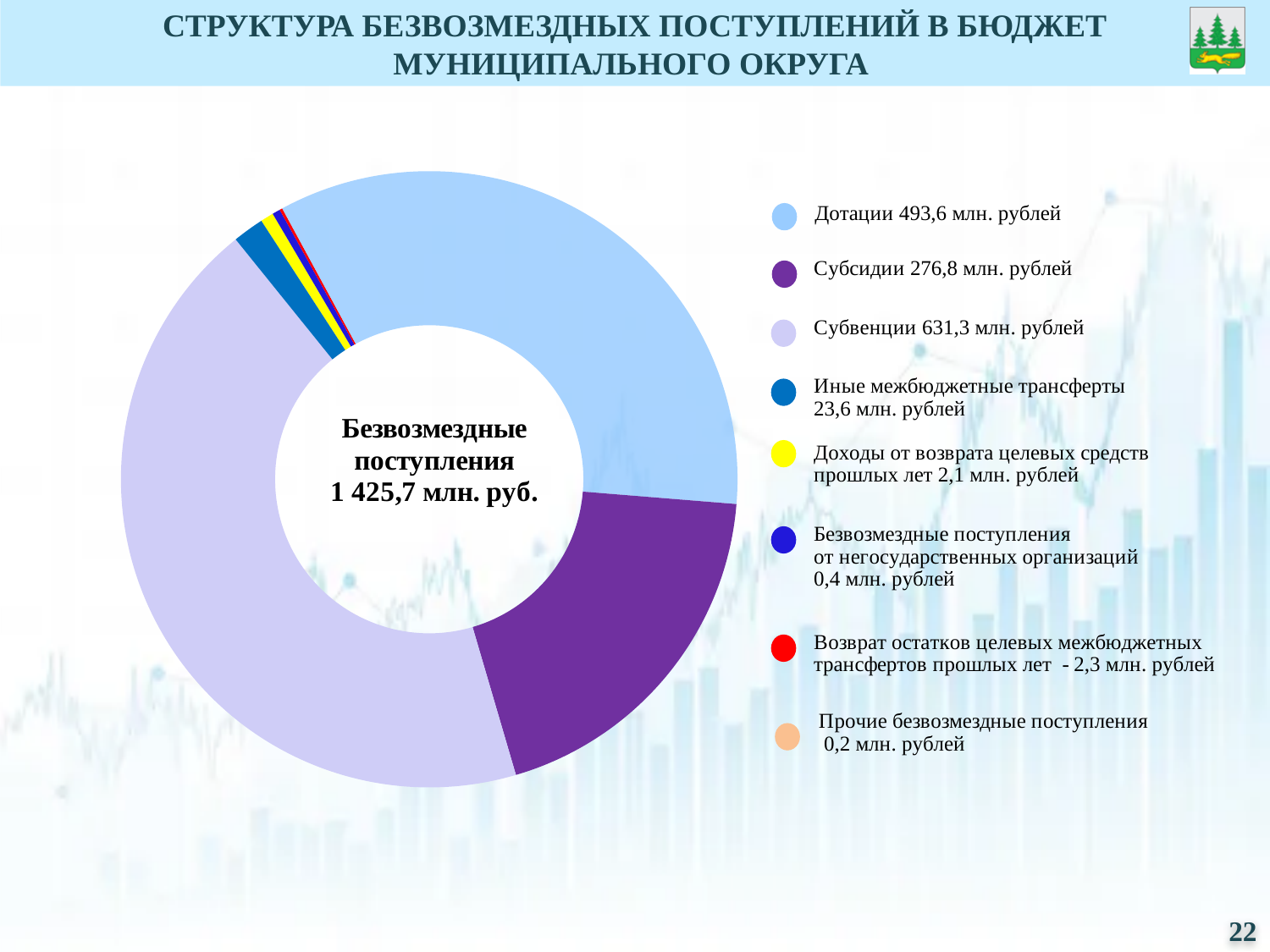
What is the value for Дотации? 493,6 млн. рублей What is the value for Иные межбюджетные трансферты? 23,6 млн. рублей What is the value for Возврат остатков целевых межбюджетных трансфертов прошлых лет? -2,3 млн. рублей Which category has the smallest value? Возврат остатков целевых межбюджетных трансфертов прошлых лет What is the difference between Субвенции and Дотации? 137,7 млн. рублей Which is larger, Дотации or Субсидии? Дотации Which category has the largest value? Субвенции How many categories does the legend list? 8 What colour represents Субвенции in the chart? Light purple (lavender) What total is shown in the centre of the donut chart? 1 425,7 млн. руб. What is the value for Субсидии? 276,8 млн. рублей What type of chart is shown on the slide? Pie (donut) chart